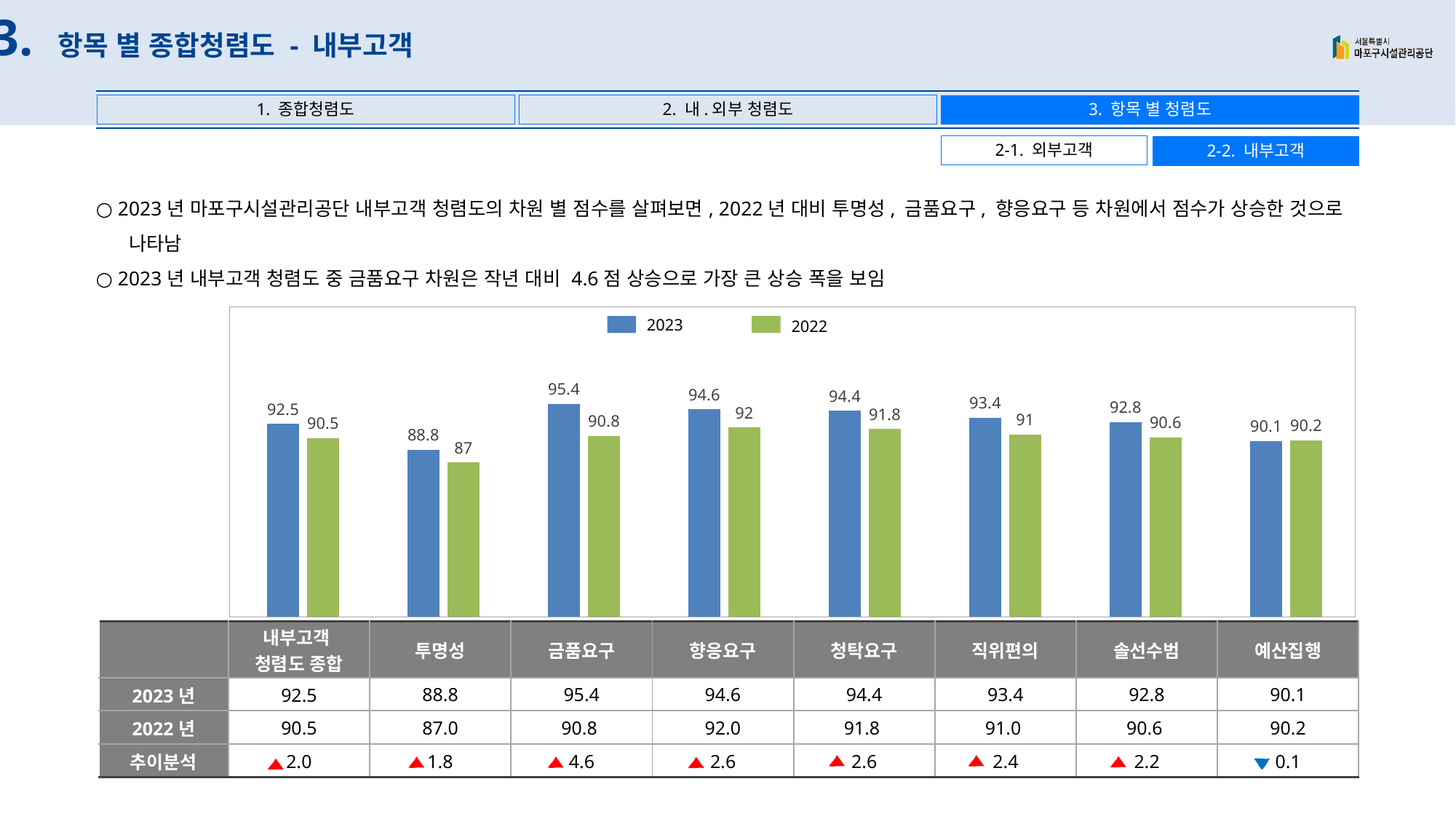
Which category has the lowest 2022 value? 투명성 Which is larger for 예산집행, the 2023 value or the 2022 value? 2022 Which category has the lowest 2023 value? 투명성 How many categories are plotted along the x axis of the chart? 8 What kind of chart is shown on the slide? bar chart What is the 2022 value for 투명성? 87 What is the 2023 value for 금품요구? 95.4 What is the 2023 value for 예산집행? 90.1 Which colour represents the 2022 series in the chart? green What is the difference between the 2023 and 2022 values for 금품요구? 4.6 Which category has the highest 2023 value? 금품요구 How many series does the chart legend list? 2